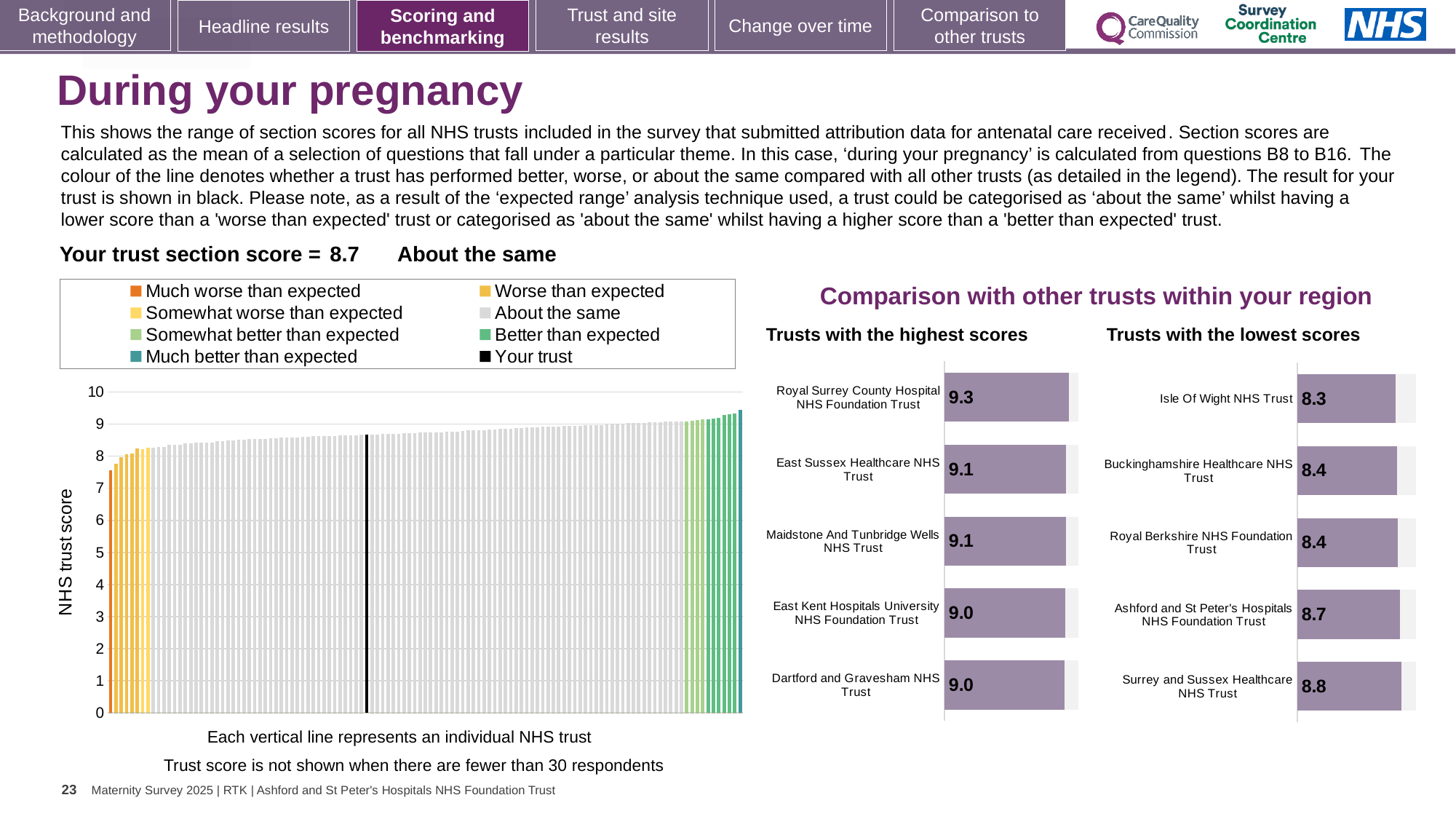
In the 'Trusts with the lowest scores' chart, what is the score for Isle Of Wight NHS Trust? 8.3 In the 'Trusts with the lowest scores' chart, what is the score for Buckinghamshire Healthcare NHS Trust? 8.4 In the 'Trusts with the highest scores' chart, what is the difference between the scores of Royal Surrey County Hospital NHS Foundation Trust and Dartford and Gravesham NHS Trust? 0.3 In the 'Trusts with the lowest scores' chart, which trust has the lowest score? Isle Of Wight NHS Trust How many entries does the legend of the 'NHS trust score' chart list? 8 How many trusts are shown in the 'Trusts with the highest scores' chart? 5 In the 'Trusts with the highest scores' chart, what is the score for Royal Surrey County Hospital NHS Foundation Trust? 9.3 In the 'Trusts with the highest scores' chart, which trust has the highest score? Royal Surrey County Hospital NHS Foundation Trust In the 'Trusts with the lowest scores' chart, what is the difference between the scores of Surrey and Sussex Healthcare NHS Trust and Isle Of Wight NHS Trust? 0.5 In the 'Trusts with the lowest scores' chart, which has the higher score: Ashford and St Peter's Hospitals NHS Foundation Trust or Surrey and Sussex Healthcare NHS Trust? Surrey and Sussex Healthcare NHS Trust In the 'NHS trust score' chart, is the value for the black 'Your trust' line greater or less than 8? greater What kind of chart is the 'NHS trust score' chart on the left of the slide? bar chart